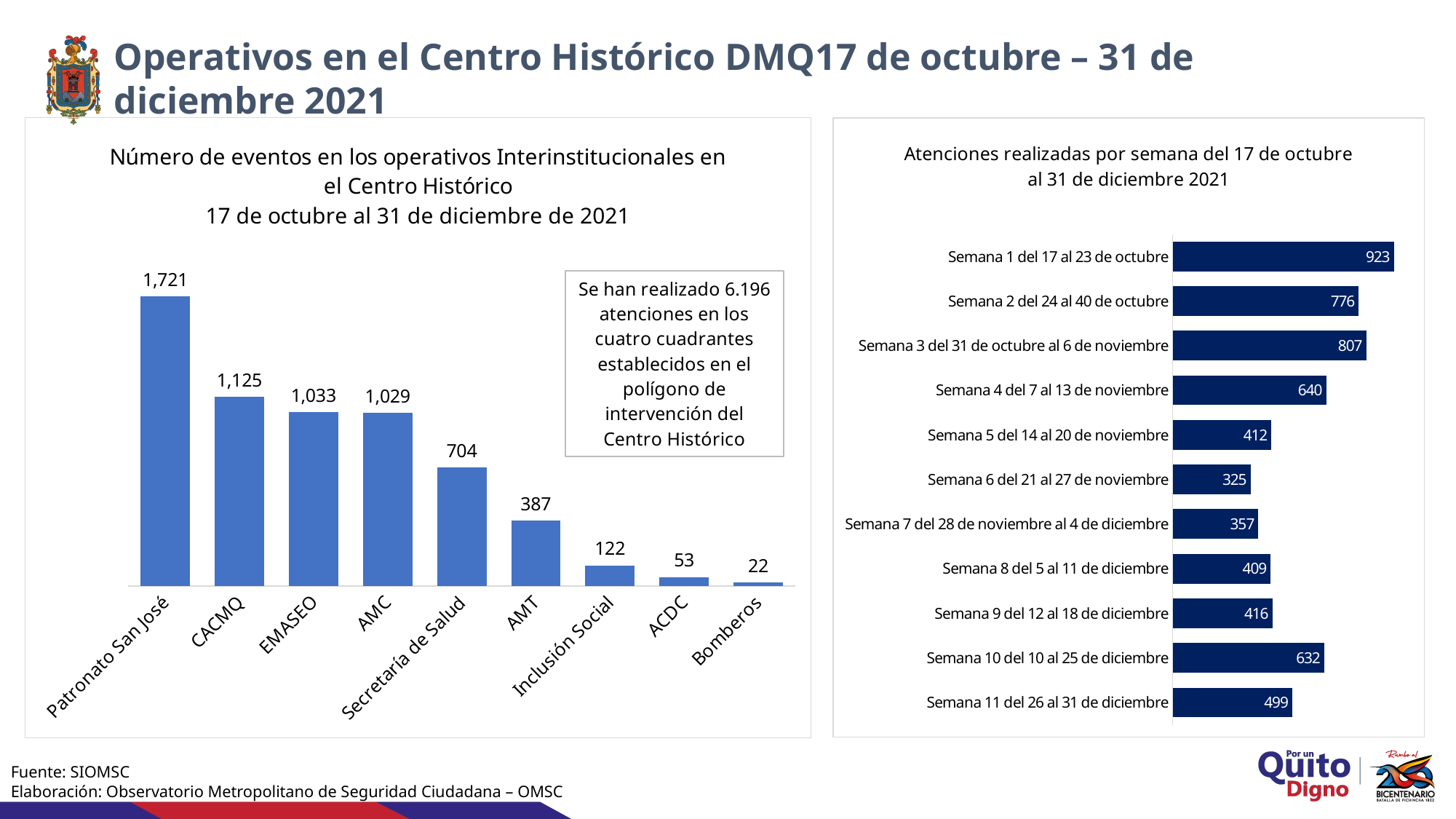
In the right chart (Atenciones realizadas por semana), which week has the lowest value? Semana 6 del 21 al 27 de noviembre In the right chart (Atenciones realizadas por semana), what is the value for Semana 4 del 7 al 13 de noviembre? 640 In the left chart (Número de eventos en los operativos Interinstitucionales), what is the difference between CACMQ and EMASEO? 92 In the left chart (Número de eventos en los operativos Interinstitucionales), what is the value for Patronato San José? 1,721 What kind of chart is the right chart (Atenciones realizadas por semana)? Bar chart In the left chart (Número de eventos en los operativos Interinstitucionales), which category has the lowest value? Bomberos In the left chart (Número de eventos en los operativos Interinstitucionales), what is the value for Secretaría de Salud? 704 In the right chart (Atenciones realizadas por semana), which week has the highest value? Semana 1 del 17 al 23 de octubre In the right chart (Atenciones realizadas por semana), how many weeks are shown? 11 In the left chart (Número de eventos en los operativos Interinstitucionales), which is larger, AMT or Inclusión Social? AMT In the right chart (Atenciones realizadas por semana), what is the difference between Semana 3 and Semana 2? 31 In the left chart (Número de eventos en los operativos Interinstitucionales), how many categories are shown? 9